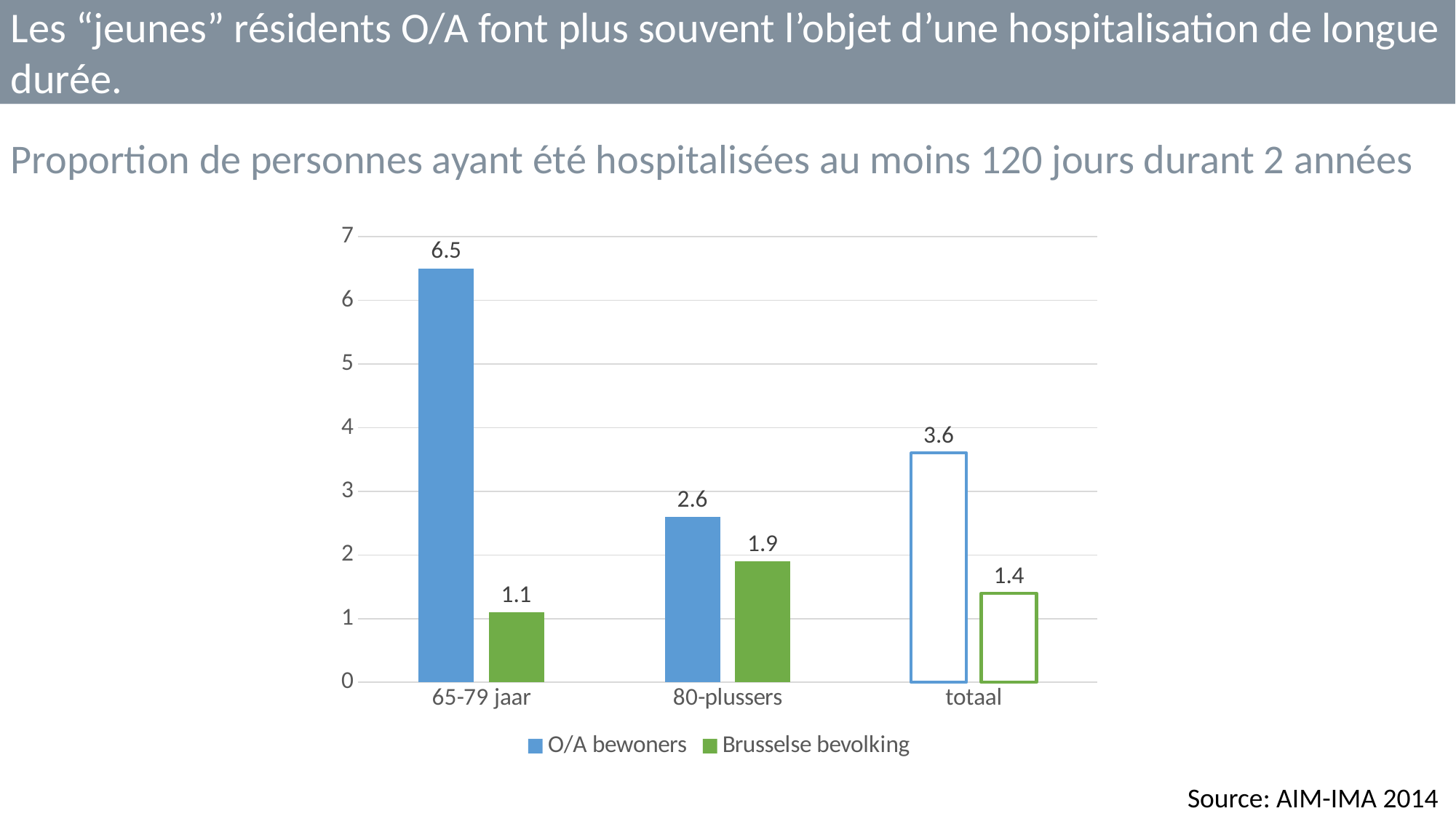
What is the value for O/A bewoners in the 65-79 jaar category? 6.5 How many categories are shown on the x axis? 3 What kind of chart is shown on the slide? Bar chart What is the value for O/A bewoners in the totaal category? 3.6 What is the value for Brusselse bevolking in the 80-plussers category? 1.9 Which is larger in the 80-plussers category: O/A bewoners or Brusselse bevolking? O/A bewoners What is the difference between O/A bewoners and Brusselse bevolking in the 65-79 jaar category? 5.4 What is the value for Brusselse bevolking in the 65-79 jaar category? 1.1 Which category has the lowest value for Brusselse bevolking? 65-79 jaar What is the difference between O/A bewoners and Brusselse bevolking in the totaal category? 2.2 Which category has the highest value for O/A bewoners? 65-79 jaar How many series does the legend list? 2